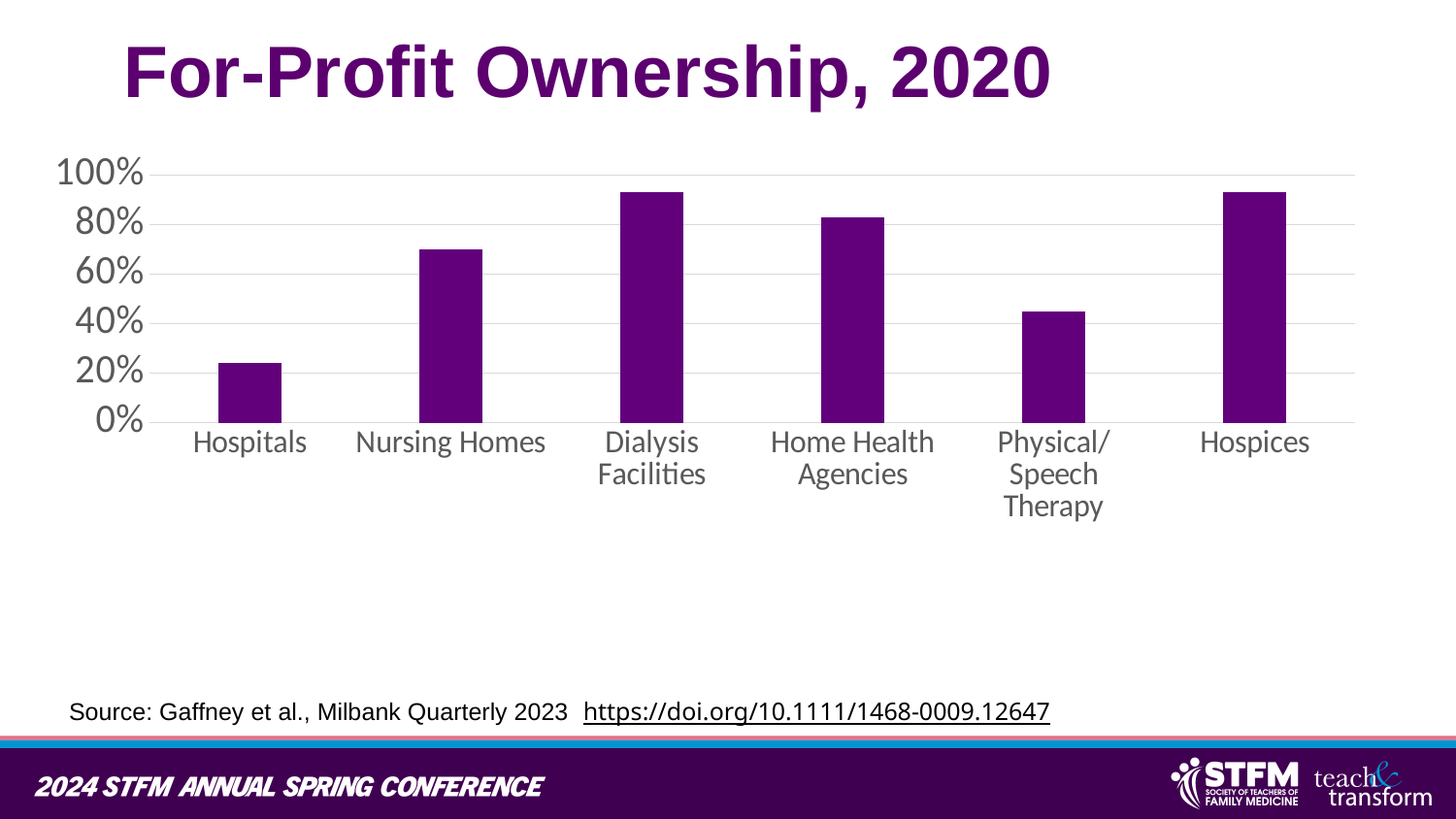
What is the title of the chart? For-Profit Ownership, 2020 Which is larger, the value for Home Health Agencies or the value for Physical/Speech Therapy? Home Health Agencies Is the value for Nursing Homes greater or less than 60%? greater Is the value for Dialysis Facilities greater or less than 80%? greater Is the value for Hospitals greater or less than 40%? less How many categories are shown on the x axis of the chart? 6 What colour are the bars in the chart? purple Which category has the lowest for-profit ownership share? Hospitals What kind of chart is shown on the slide? bar chart Which is larger, the value for Nursing Homes or the value for Hospitals? Nursing Homes